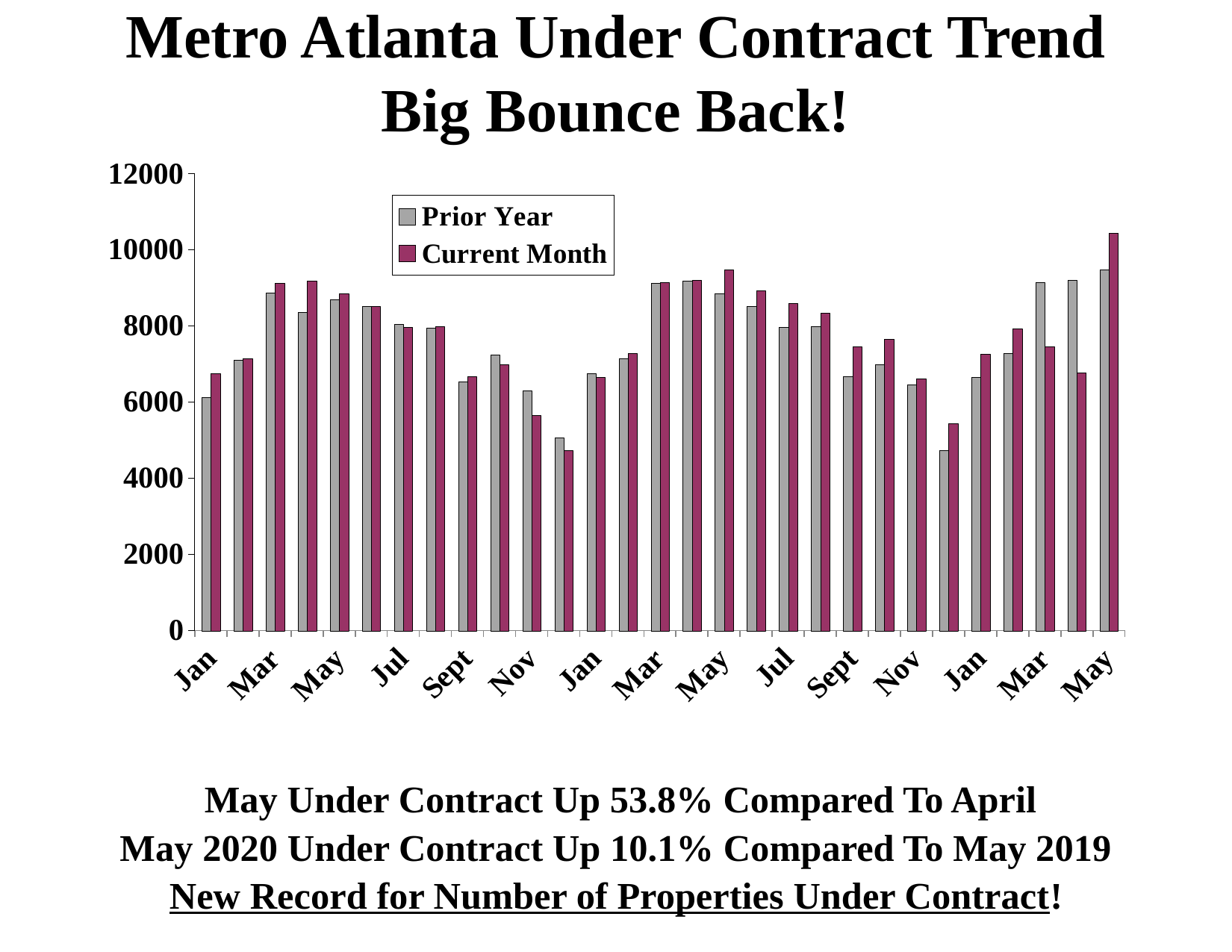
What kind of chart is shown on the slide? Bar chart For the rightmost Mar, which is larger, the Prior Year bar or the Current Month bar? Prior Year What are the two series named in the legend? Prior Year and Current Month Is the Current Month value for the rightmost May greater or less than 10000? greater For the rightmost May, which is larger, the Prior Year bar or the Current Month bar? Current Month Is the Prior Year value for the rightmost Mar greater or less than 8000? greater Is the Current Month value for the leftmost Nov greater or less than 6000? less How many series does the legend list? 2 Which month has the highest Current Month bar? The rightmost May What is the title of the chart? Metro Atlanta Under Contract Trend Big Bounce Back!